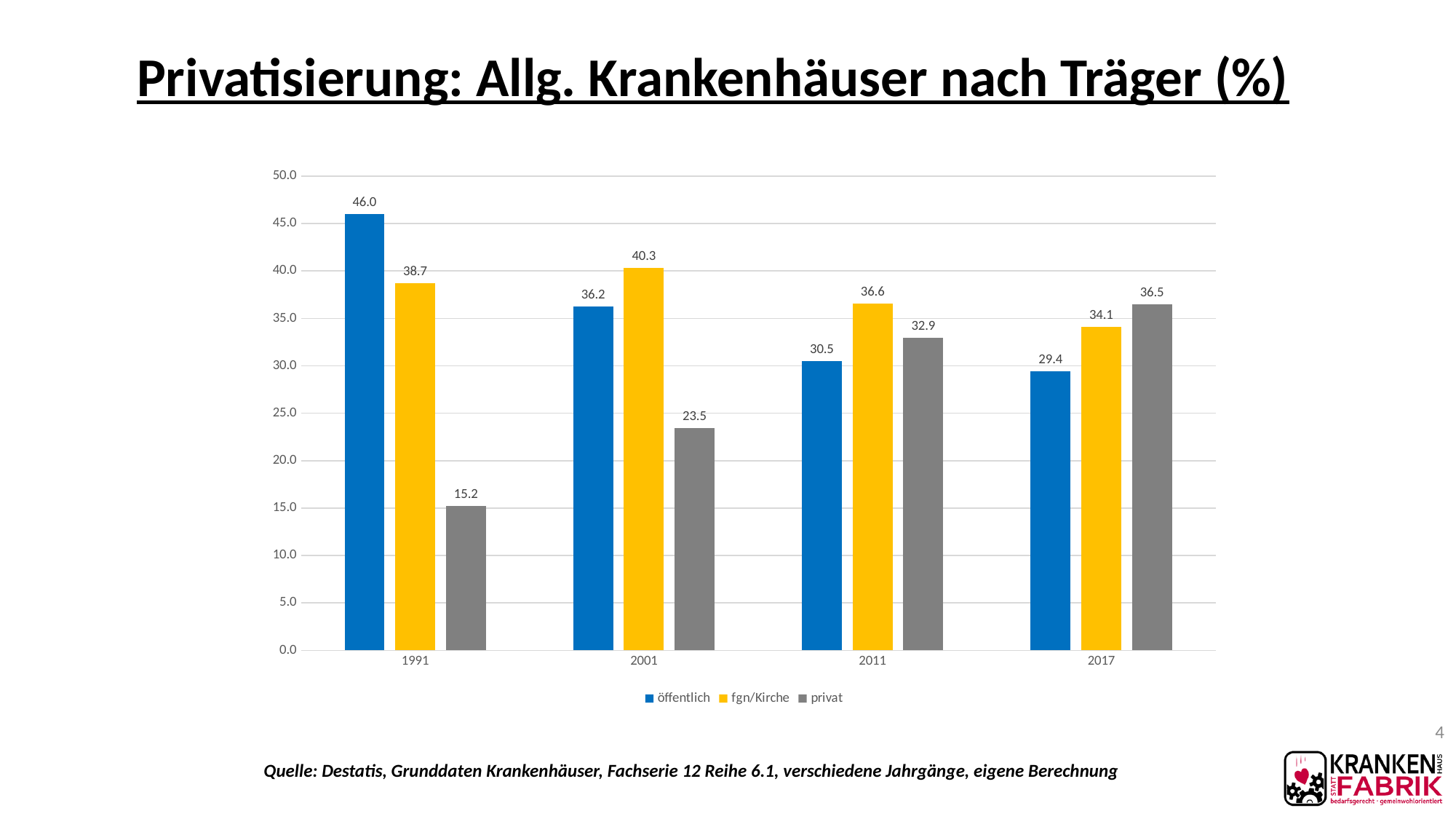
What is the difference between the privat values in 2017 and 1991? 21.3 In which year is the öffentlich series highest? 1991 What is the value for öffentlich in 1991? 46.0 What is the value for privat in 2017? 36.5 What is the value for fgn/Kirche in 2001? 40.3 Which is larger in 2011: öffentlich or privat? privat Does the öffentlich series rise or fall from 1991 to 2017? fall In which year is the privat series lowest? 1991 How many years are shown on the x axis? 4 What kind of chart is shown? bar chart How many series does the legend list? 3 Which colour represents the fgn/Kirche series? yellow